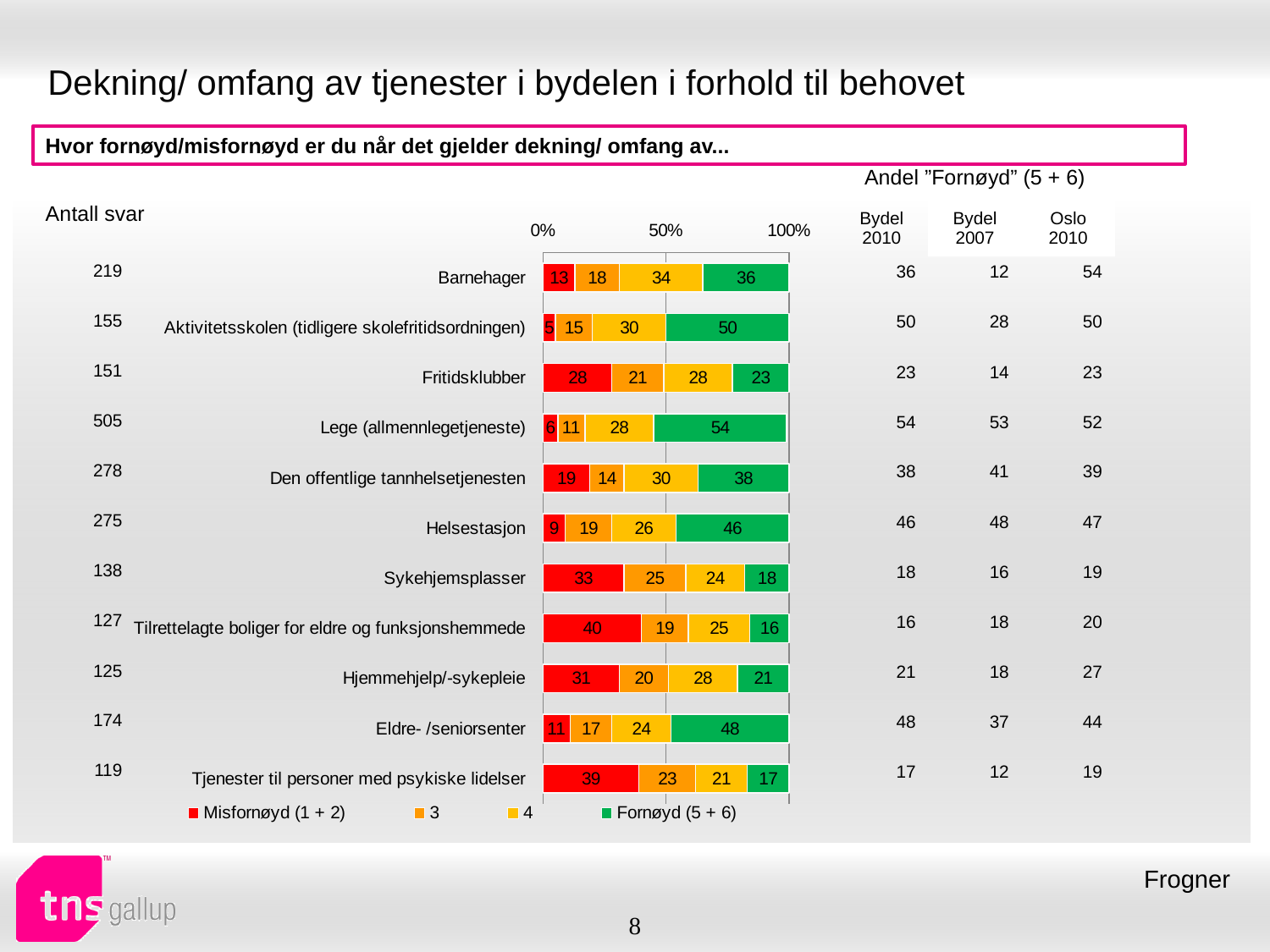
Which has the larger Fornøyd (5 + 6) value, Helsestasjon or Eldre- /seniorsenter? Eldre- /seniorsenter How many series does the chart legend list? 4 What kind of chart is shown on the slide? Stacked bar chart What is the value of the '4' segment for Helsestasjon? 26 What is the total of the stacked bar for Fritidsklubber? 100 How many service categories are plotted in the chart? 11 What is the Misfornøyd (1 + 2) value for Tilrettelagte boliger for eldre og funksjonshemmede? 40 What is the value of the '3' segment for Sykehjemsplasser? 25 Which category has the highest Fornøyd (5 + 6) value? Lege (allmennlegetjeneste) What is the difference between the Fornøyd (5 + 6) values for Barnehager and Fritidsklubber? 13 Which category has the lowest Fornøyd (5 + 6) value? Tilrettelagte boliger for eldre og funksjonshemmede What is the Fornøyd (5 + 6) value for Lege (allmennlegetjeneste)? 54